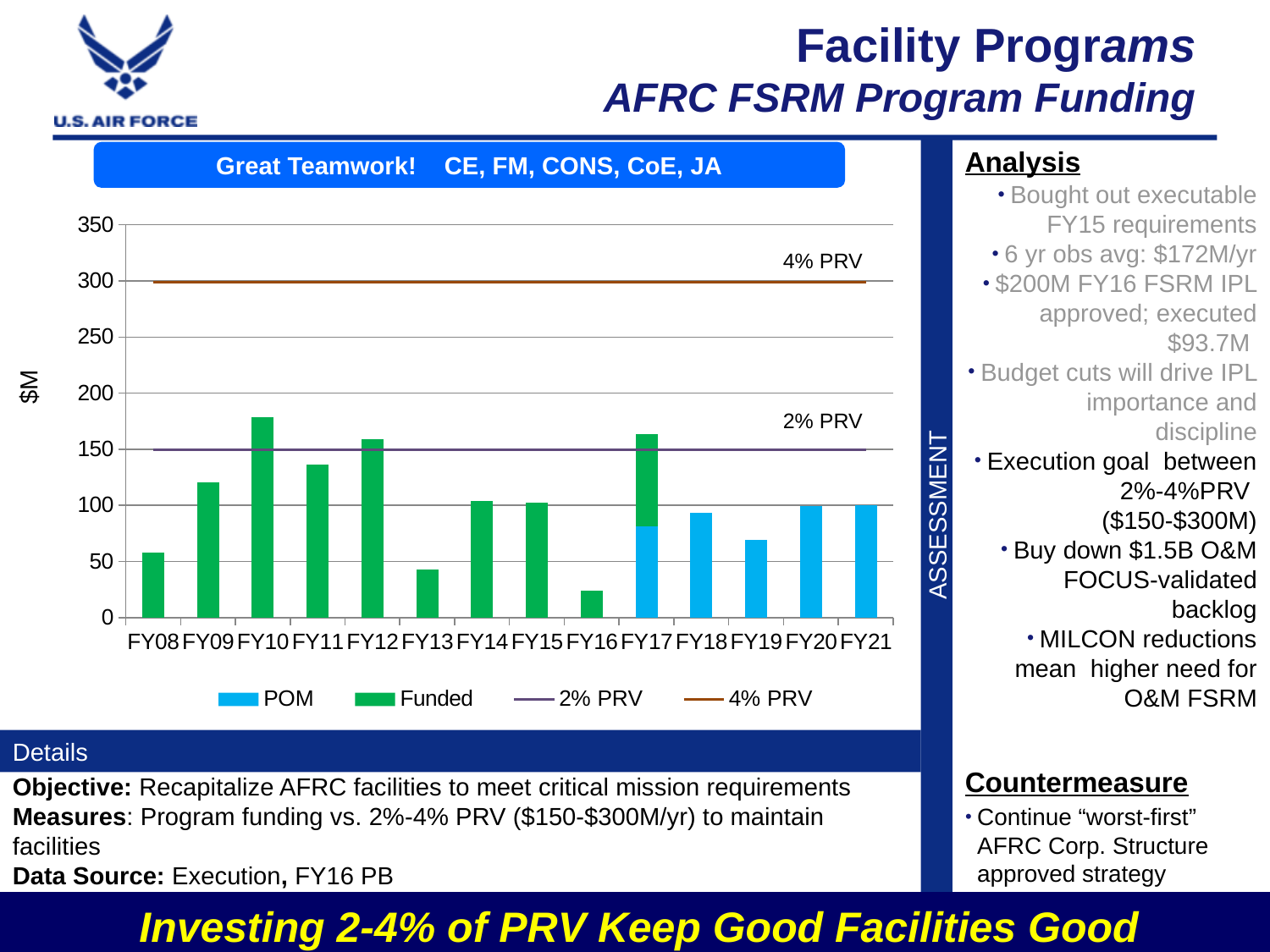
Which fiscal year has the lowest Funded bar? FY16 Is the Funded value for FY13 greater or less than 50? less At what value on the $M axis is the 4% PRV line drawn? 300 Is the Funded value for FY08 greater or less than 100? less Which fiscal year has the highest Funded bar? FY10 What kind of chart is shown on the slide? bar chart Is the Funded value for FY10 greater or less than 150? greater Do the Funded values rise or fall from FY08 to FY10? rise How many fiscal years are shown on the x axis of the chart? 14 Which is larger, the Funded value for FY10 or for FY11? FY10 At what value on the $M axis is the 2% PRV line drawn? 150 How many series does the chart legend list? 4